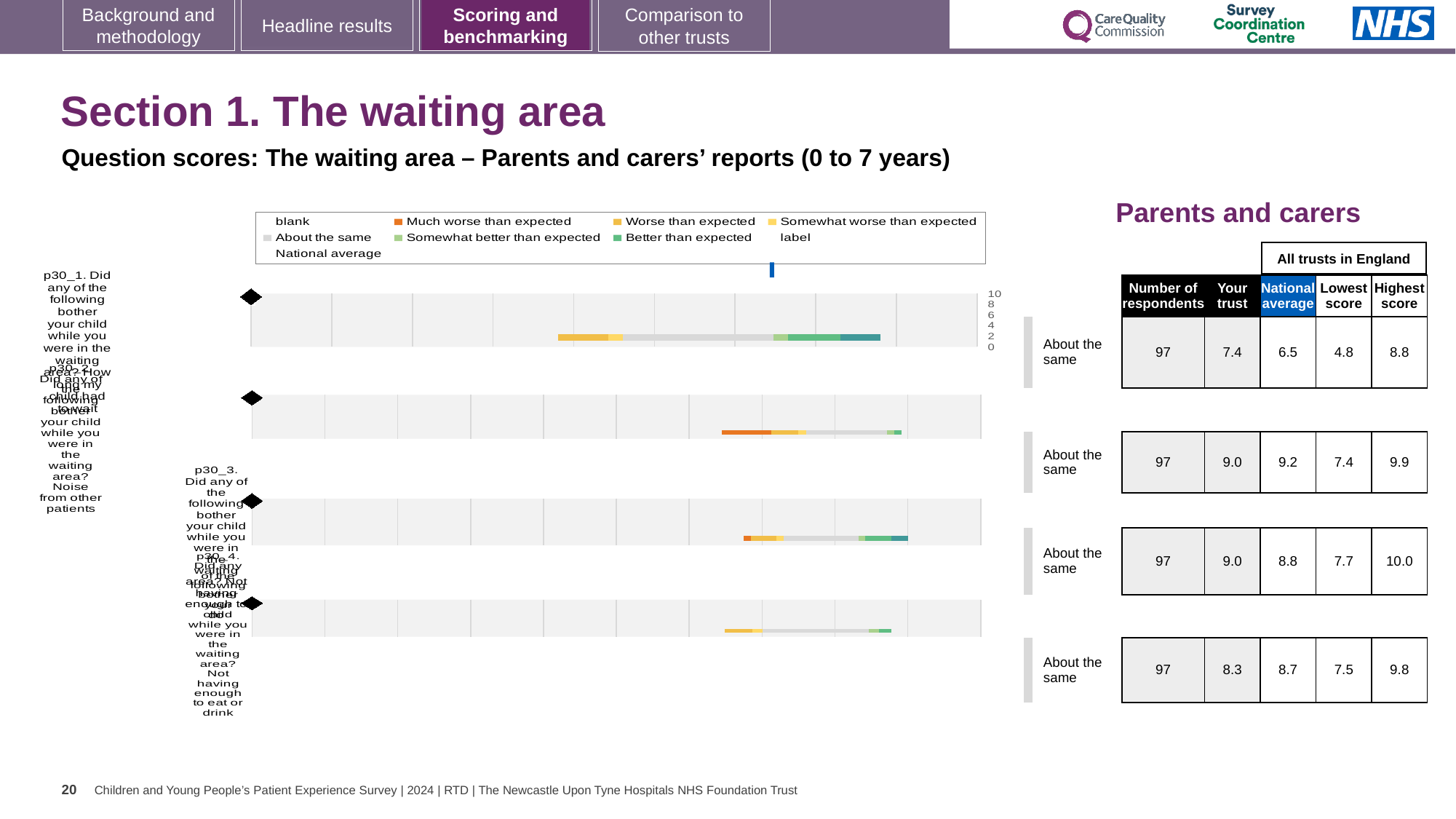
In the chart legend, which colour represents 'Much worse than expected'? orange In the chart legend, which colour represents 'About the same'? grey How many horizontal bars (survey questions) are plotted in the chart? 4 What is the lowest value shown on the chart's numeric axis? 0 What kind of chart is shown on the slide? bar chart What is the highest value shown on the chart's numeric axis? 10